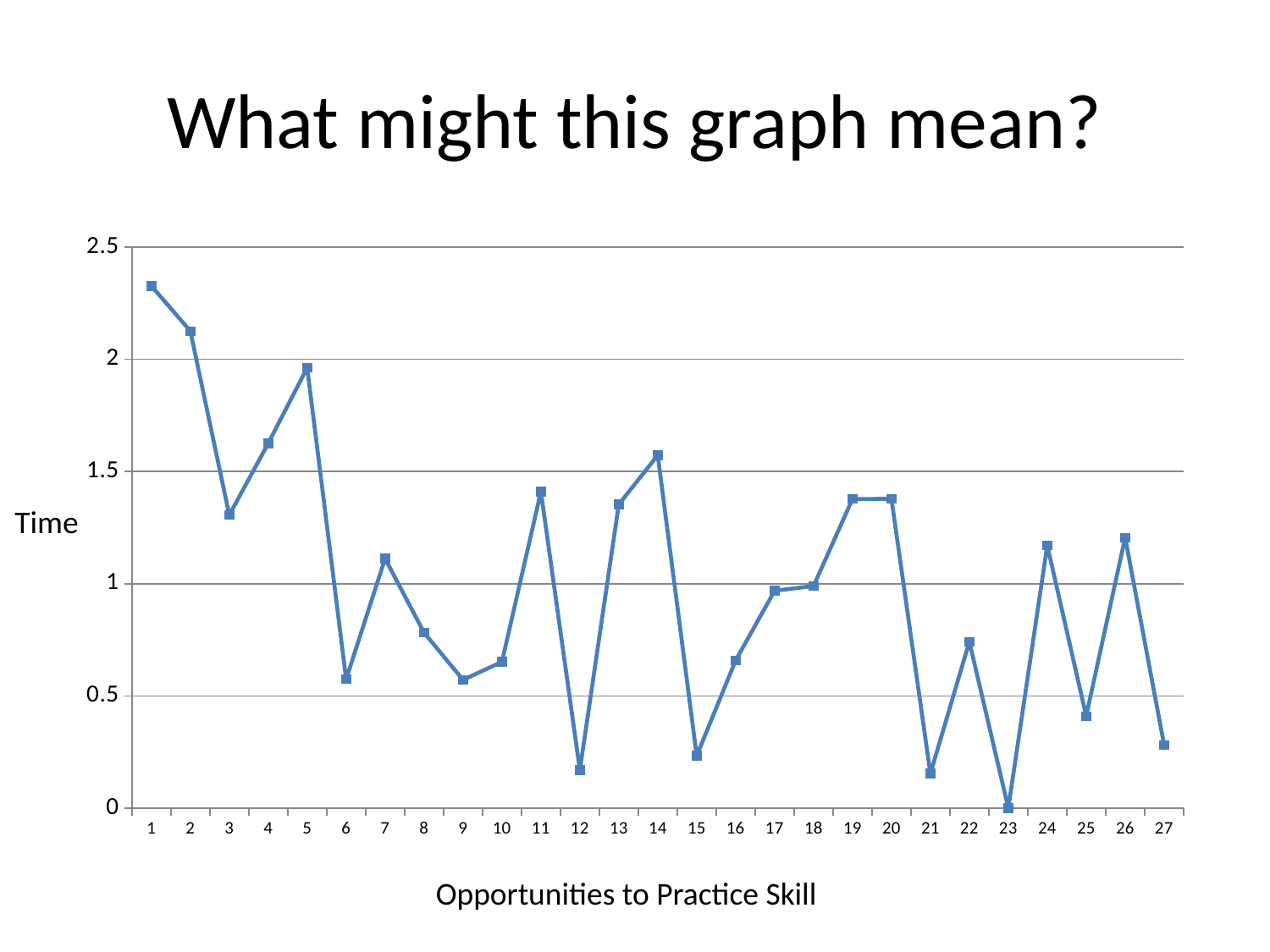
Which has the larger time value, opportunity 5 or opportunity 6? opportunity 5 Overall, does the time tend to rise or fall as the number of opportunities to practice increases? fall Is the time value at opportunity 26 greater or less than 1? greater Is the time value at opportunity 14 greater or less than 1.5? greater At which opportunity number is the time highest? 1 What is the time value at opportunity 23? 0 At which opportunity number is the time lowest? 23 Is the time value at opportunity 12 greater or less than 0.5? less What is the label on the x axis of the chart? Opportunities to Practice Skill How many opportunities (points) are plotted along the x axis? 27 What kind of chart is shown on the slide? line chart